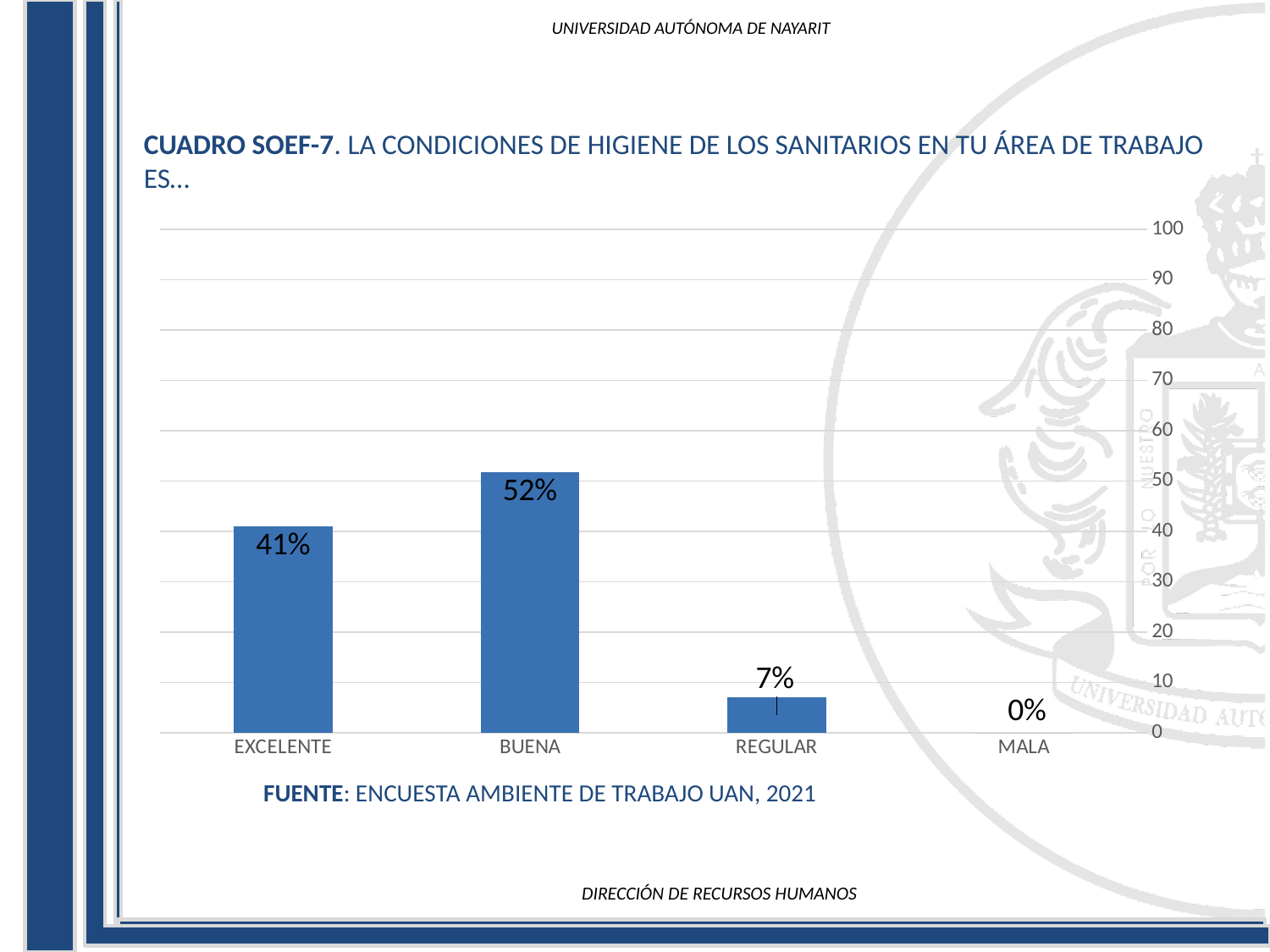
What is the value for EXCELENTE? 41% Is the value for BUENA greater or less than 50? greater What is the value for BUENA? 52% What is the difference between the values for BUENA and EXCELENTE? 11% Which category has the highest value? BUENA Which is larger, the value for EXCELENTE or the value for REGULAR? EXCELENTE What is the value for REGULAR? 7% What is the value for MALA? 0% Which category has the lowest value? MALA How many categories are shown on the x axis? 4 What is the difference between the values for EXCELENTE and REGULAR? 34% What kind of chart is shown on the slide? bar chart